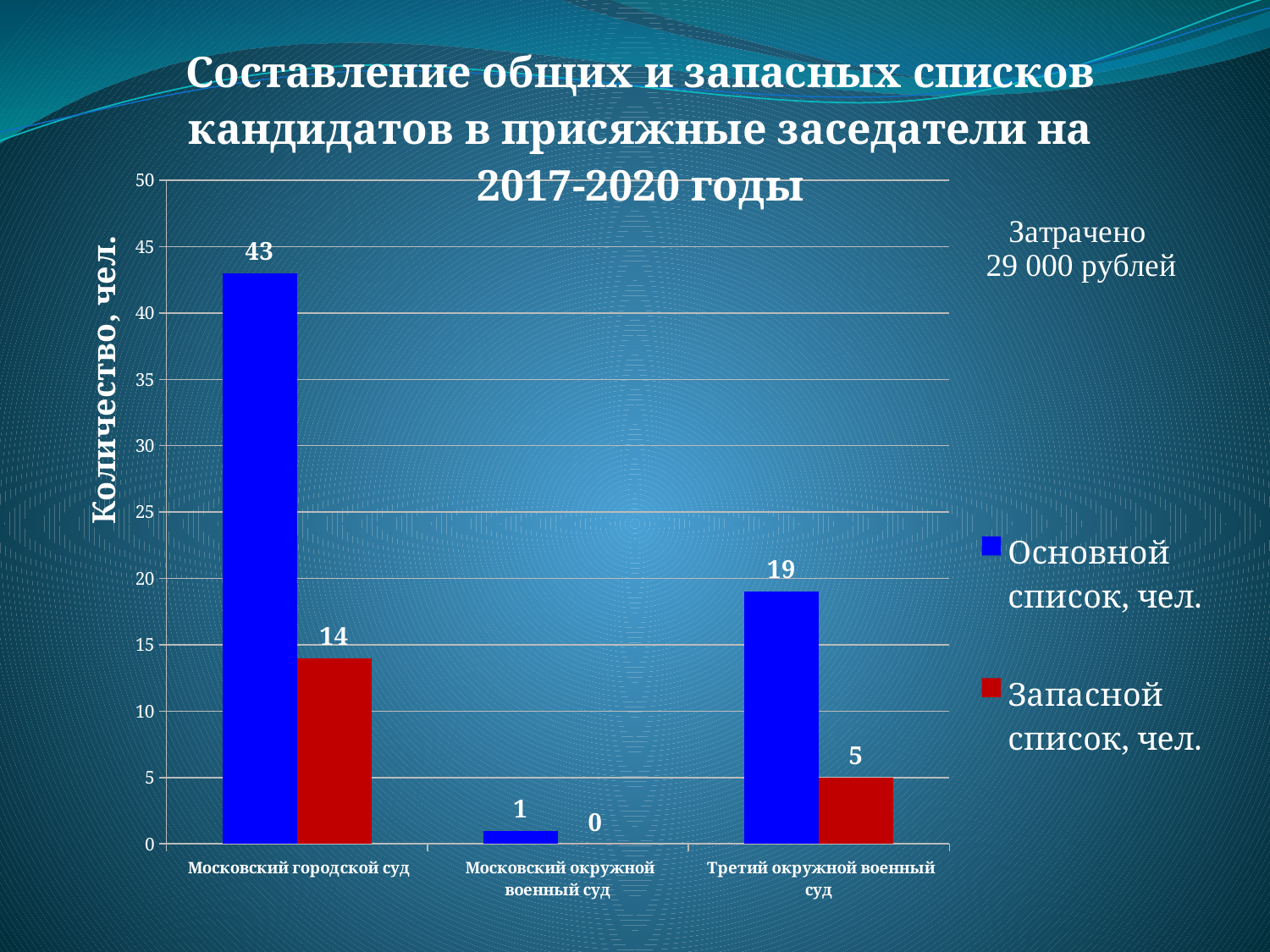
How many courts (categories) are shown on the x axis? 3 What is the value of the Запасной список, чел. series for Третий окружной военный суд? 5 What is the value of the Основной список, чел. series for Московский городской суд? 43 Which is larger: the Основной список value for Третий окружной военный суд or the Запасной список value for Московский городской суд? Основной список value for Третий окружной военный суд How many series does the legend list? 2 What is the difference between the Основной список and Запасной список values for Московский городской суд? 29 Which court has the highest value in the Основной список, чел. series? Московский городской суд What kind of chart is shown on the slide? bar chart What is the label of the vertical axis? Количество, чел. Is the Основной список value for Московский городской суд greater or less than 40? greater What is the value of the Запасной список, чел. series for Московский окружной военный суд? 0 Which court has the lowest value in the Основной список, чел. series? Московский окружной военный суд